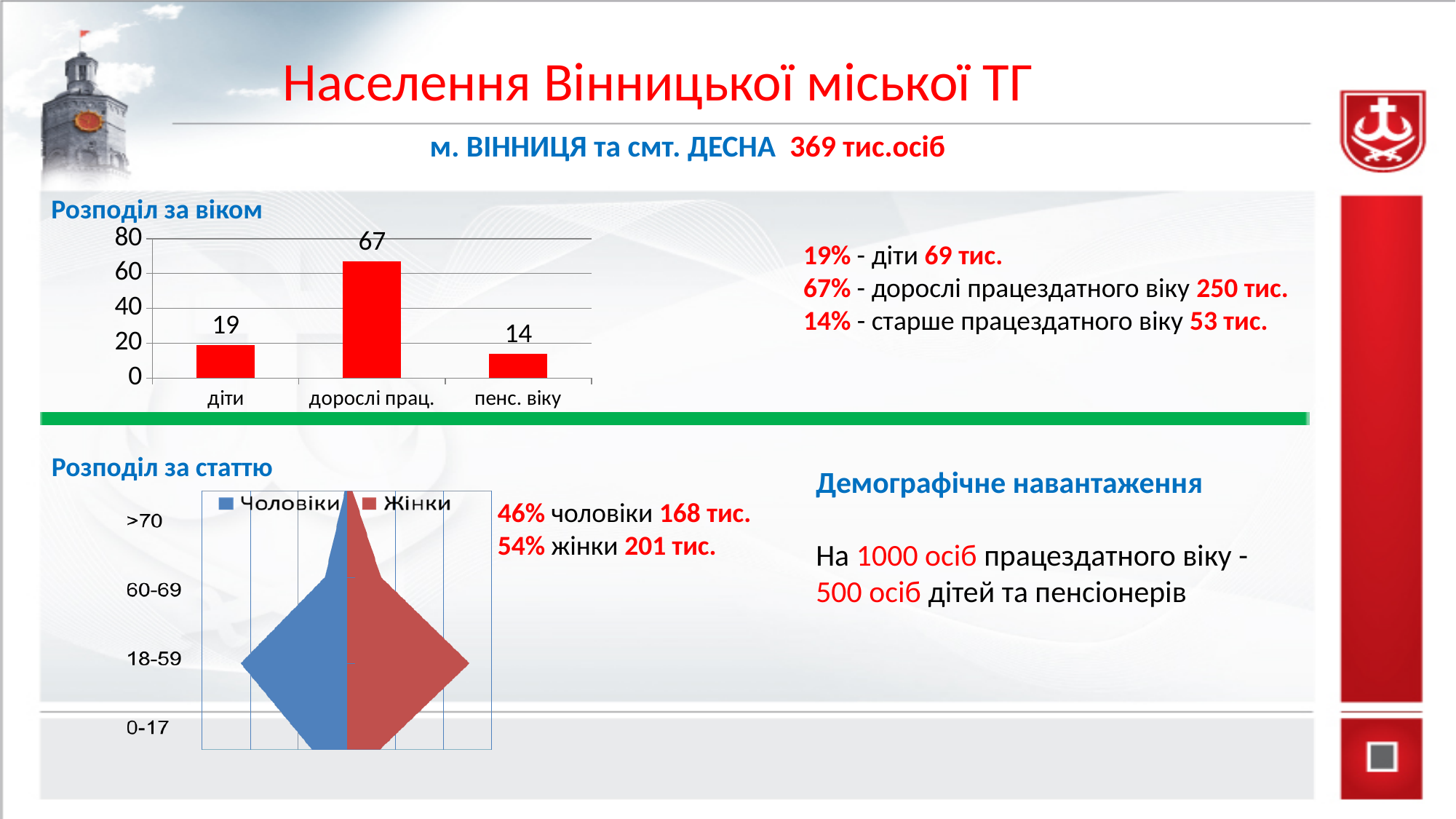
In the "Розподіл за віком" chart, what is the value for "пенс. віку"? 14 In the "Розподіл за віком" chart, what is the difference between the values for "дорослі прац." and "діти"? 48 How many series does the legend of the "Розподіл за статтю" chart list? 2 In the "Розподіл за віком" chart, what is the value for "дорослі прац."? 67 How many categories are shown in the "Розподіл за віком" chart? 3 In the "Розподіл за віком" chart, which is larger: the value for "діти" or the value for "пенс. віку"? діти In the "Розподіл за віком" chart, which category has the lowest value? пенс. віку In the "Розподіл за віком" chart, is the value for "дорослі прац." greater or less than 60? greater In the "Розподіл за статтю" chart, which series is shown in blue? Чоловіки In the "Розподіл за віком" chart, what is the value for "діти"? 19 In the "Розподіл за віком" chart, which category has the highest value? дорослі прац. What type of chart is the "Розподіл за віком" chart? bar chart